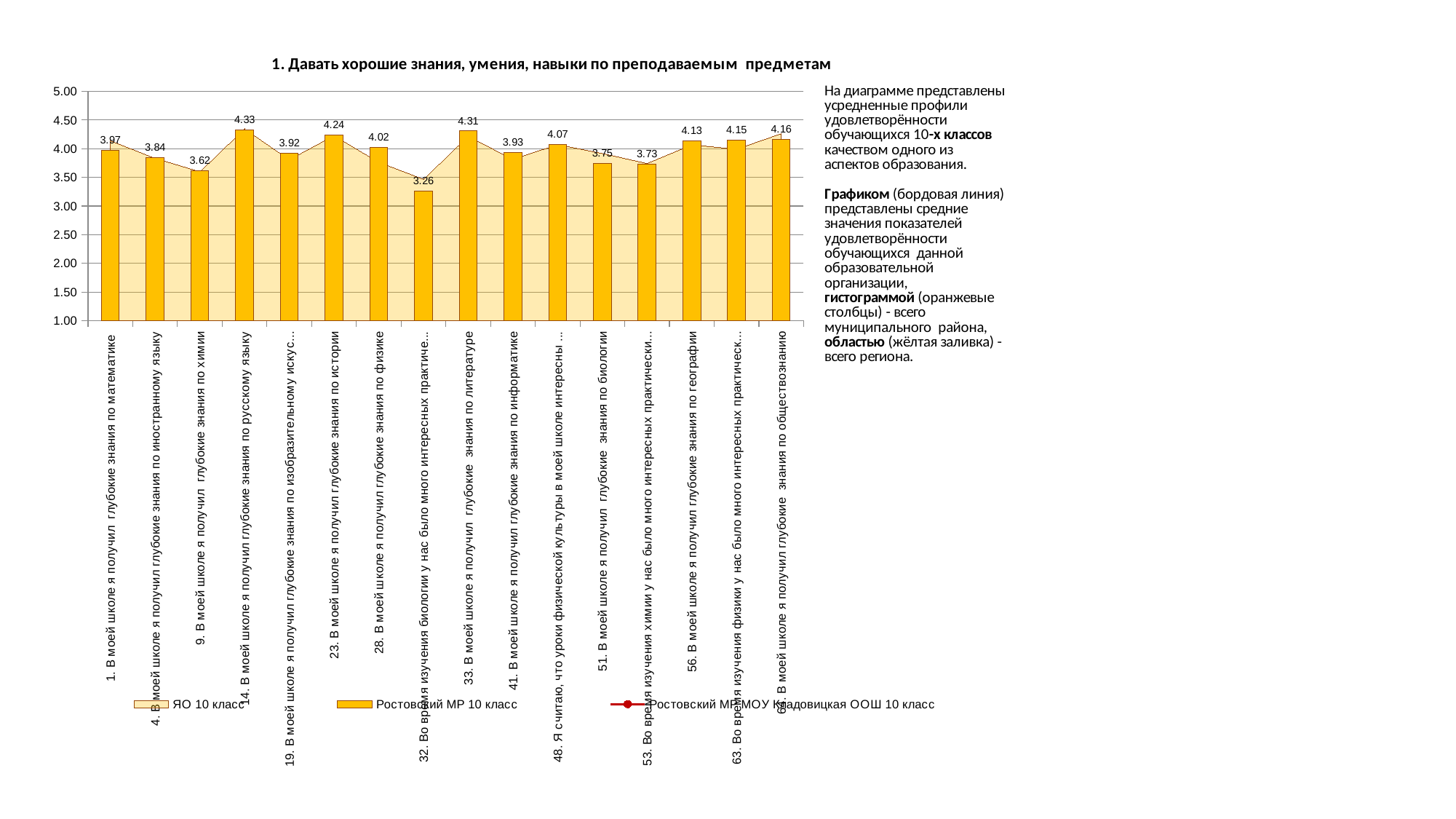
What is the labelled value for the bar '1. В моей школе я получил глубокие знания по математике'? 3.97 Is the bar value for '9. В моей школе я получил глубокие знания по химии' greater or less than 4.00? less Which category has the lowest labelled bar value? 32. Во время изучения биологии у нас было много интересных практиче... What is the labelled value for the bar '28. В моей школе я получил глубокие знания по физике'? 4.02 What kind of chart is used for the Ростовский МР 10 класс series? bar chart What is the difference between the highest labelled bar value (4.33) and the lowest (3.26)? 1.07 How many categories are plotted along the x axis? 16 What is the title of the chart? 1. Давать хорошие знания, умения, навыки по преподаваемым предметам How many series does the chart legend list? 3 Which category has the highest labelled bar value? 14. В моей школе я получил глубокие знания по русскому языку Which bar is higher: '23. В моей школе я получил глубокие знания по истории' or '28. В моей школе я получил глубокие знания по физике'? 23. В моей школе я получил глубокие знания по истории What is the labelled value for the bar '56. В моей школе я получил глубокие знания по географии'? 4.13